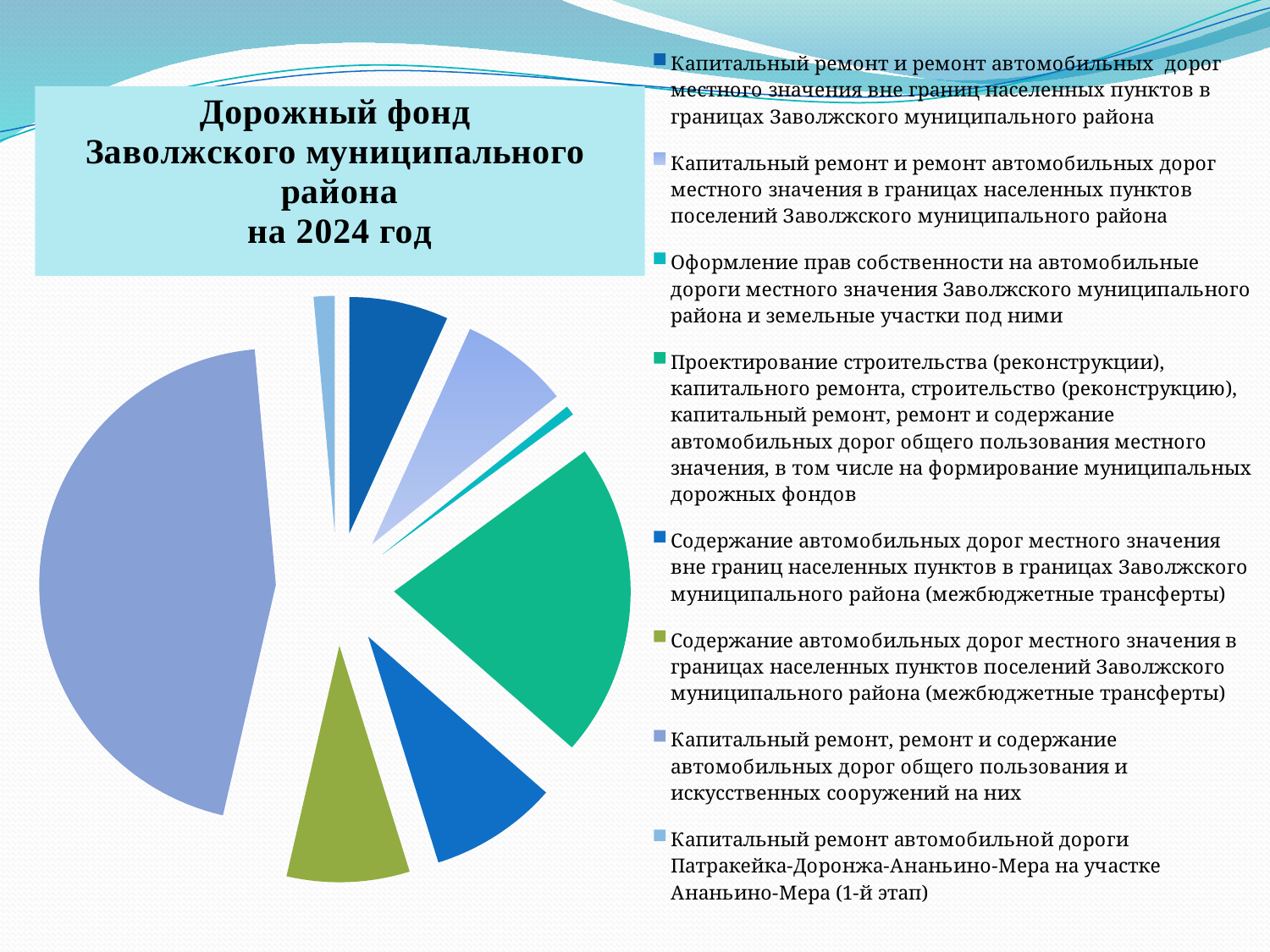
Which is larger: the slice for "Капитальный ремонт автомобильной дороги Патракейка-Доронжа-Ананьино-Мера..." or the slice for "Капитальный ремонт и ремонт автомобильных дорог местного значения вне границ населенных пунктов..."? Капитальный ремонт и ремонт автомобильных дорог местного значения вне границ населенных пунктов... How many categories does the legend of the pie chart list? 8 What is the title of the chart on the slide? Дорожный фонд Заволжского муниципального района на 2024 год Which is larger: the slice for "Капитальный ремонт, ремонт и содержание автомобильных дорог общего пользования и искусственных сооружений на них" or the slice for "Проектирование строительства (реконструкции), капитального ремонта..."? Капитальный ремонт, ремонт и содержание автомобильных дорог общего пользования и искусственных сооружений на них What kind of chart is shown on the slide? pie chart Which category has the largest slice of the pie chart? Капитальный ремонт, ремонт и содержание автомобильных дорог общего пользования и искусственных сооружений на них Which is larger: the slice for "Оформление прав собственности на автомобильные дороги местного значения..." or the slice for "Содержание автомобильных дорог местного значения в границах населенных пунктов поселений... (межбюджетные трансферты)"? Содержание автомобильных дорог местного значения в границах населенных пунктов поселений... (межбюджетные трансферты) What colour is the largest slice of the pie chart? light purple-blue (lavender) How many slices does the pie chart have? 8